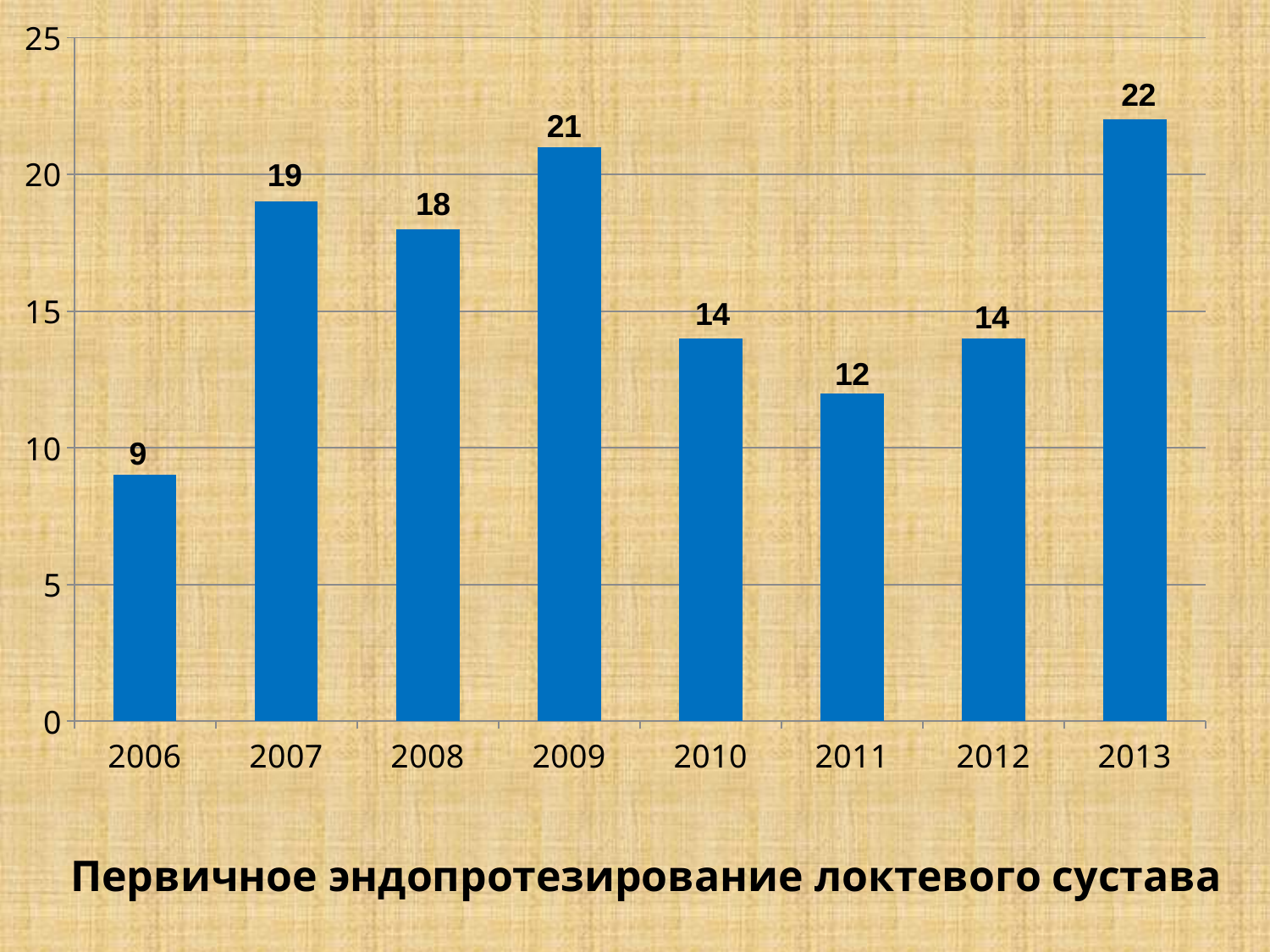
What is the value for 2009? 21 Which year has the highest value? 2013 What is the difference between the values for 2013 and 2006? 13 Is the value for 2012 greater or less than 15? less What kind of chart is this? bar chart What is the difference between the values for 2009 and 2010? 7 What is the value for 2006? 9 How many years are shown on the x axis? 8 Which year has the lowest value? 2006 What is the title text shown below the chart? Первичное эндопротезирование локтевого сустава What is the value for 2011? 12 Which is larger, the value for 2007 or the value for 2008? 2007